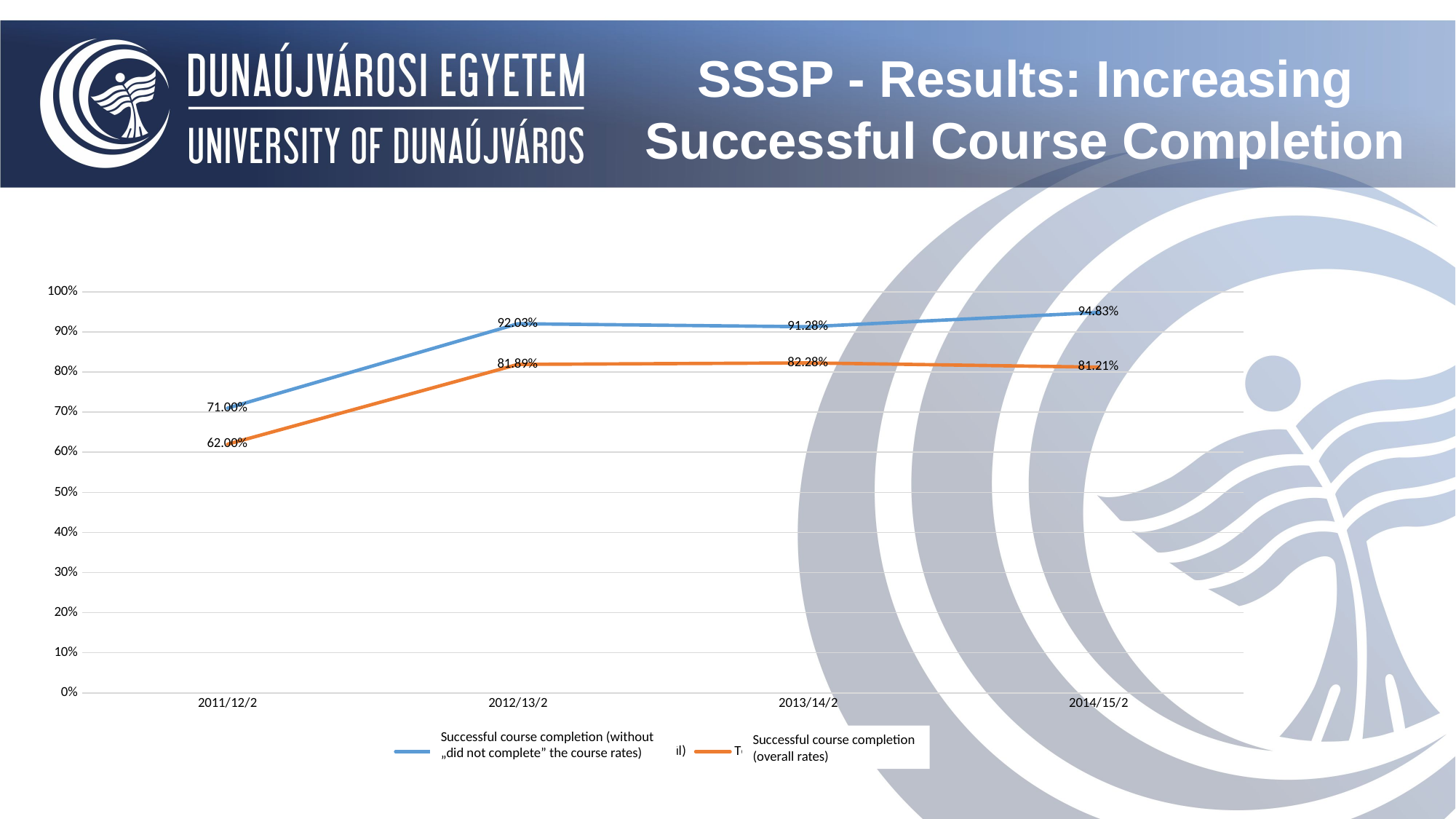
What kind of chart is shown on the slide? line chart Which is larger in 2014/15/2: the rate without "did not complete" the course rates or the overall rate? the rate without "did not complete" the course rates In which period is the successful course completion rate (overall rates) highest? 2013/14/2 What is the successful course completion rate (overall rates) for 2013/14/2? 82.28% What is the successful course completion rate (overall rates) for 2011/12/2? 62.00% How many series does the legend list? 2 How many periods are shown on the x axis? 4 What is the successful course completion rate (without "did not complete" the course rates) for 2014/15/2? 94.83% What is the difference between the two series' values in 2011/12/2? 9.00% What is the successful course completion rate (without "did not complete" the course rates) for 2012/13/2? 92.03% Does the successful course completion rate (overall rates) rise or fall from 2011/12/2 to 2012/13/2? rise In which period is the successful course completion rate (without "did not complete" the course rates) lowest? 2011/12/2